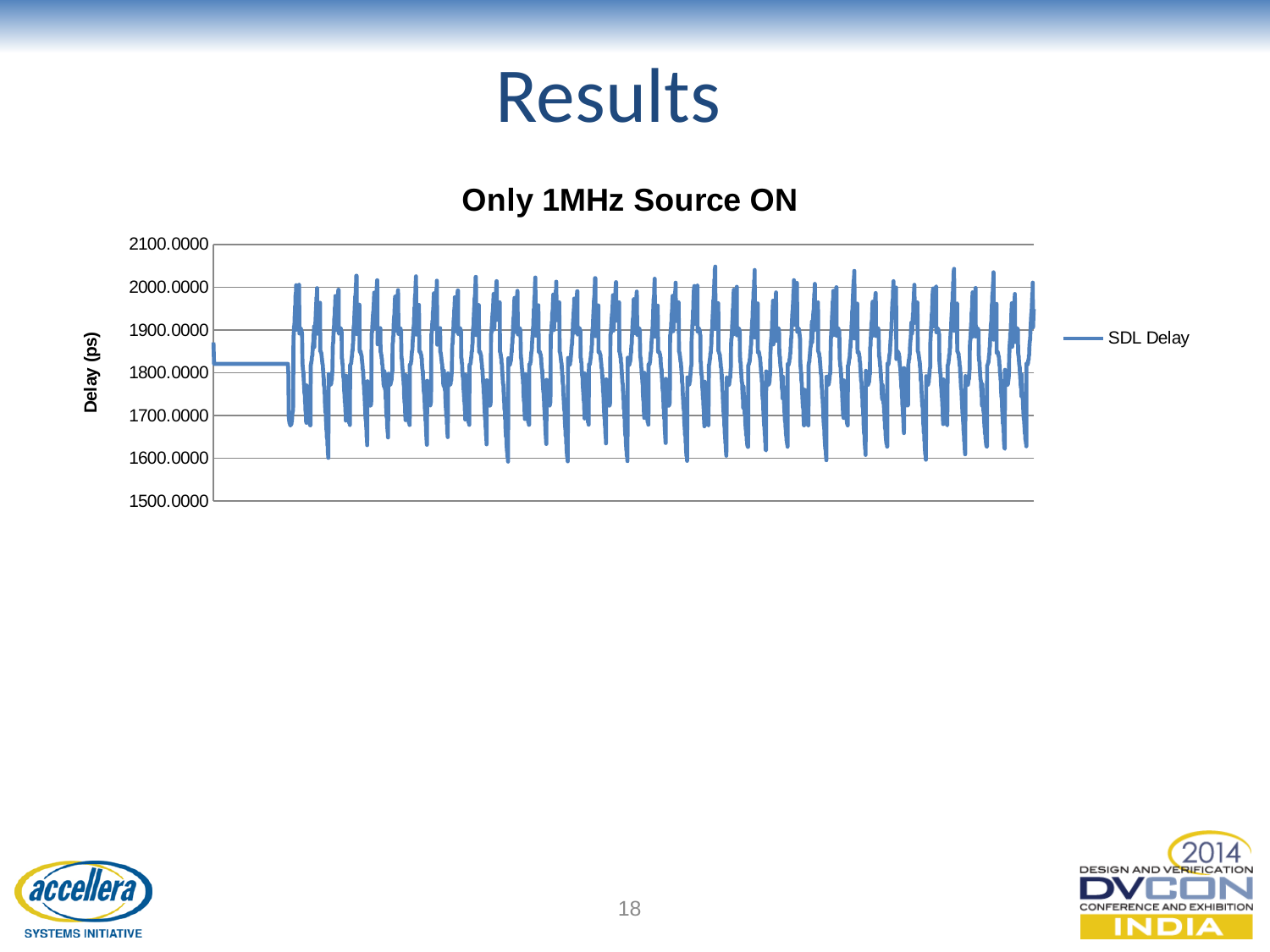
Is the lowest dip of the SDL Delay line greater or less than 1700.0000? less Is the flat initial segment of the SDL Delay line, before the oscillation starts, greater or less than 1900.0000? less What is the lowest value shown on the vertical axis? 1500.0000 Is the flat initial segment of the SDL Delay line, before the oscillation starts, greater or less than 1700.0000? greater What is the name of the series shown in the legend? SDL Delay How many series does the chart's legend list? 1 What is the label of the vertical axis? Delay (ps) What kind of chart is shown on the slide? line chart